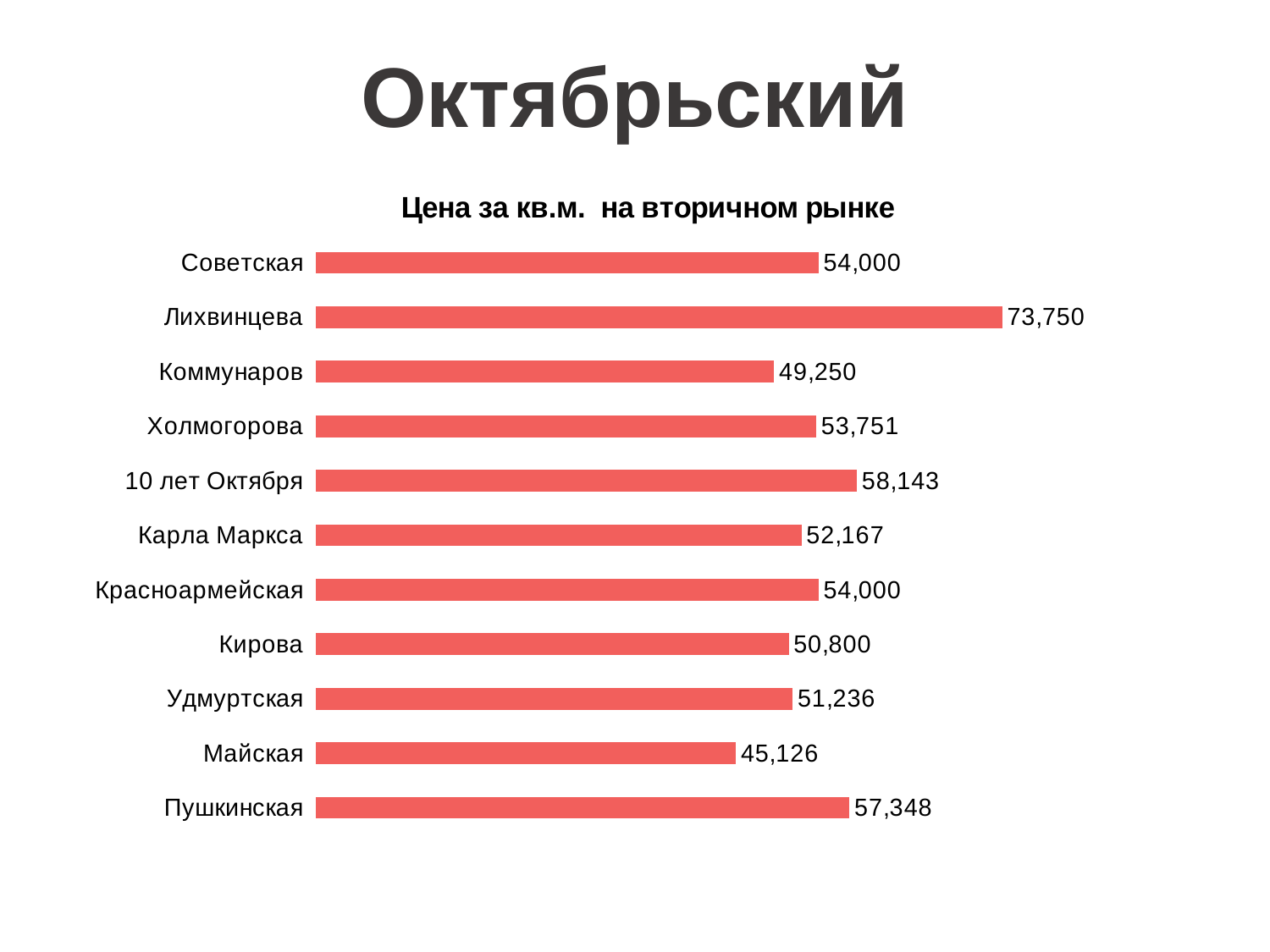
Which category has the lowest value? Майская What is the difference between the values for Лихвинцева and Майская? 28,624 What is the value for 10 лет Октября? 58,143 What is the value for Лихвинцева? 73,750 Which is larger, the value for Холмогорова or the value for Удмуртская? Холмогорова What is the title of the chart? Цена за кв.м. на вторичном рынке How many categories are shown in the chart? 11 What is the difference between the values for Пушкинская and Коммунаров? 8,098 What is the value for Майская? 45,126 What is the value for Кирова? 50,800 What kind of chart is shown on the slide? Bar chart Which category has the highest value? Лихвинцева